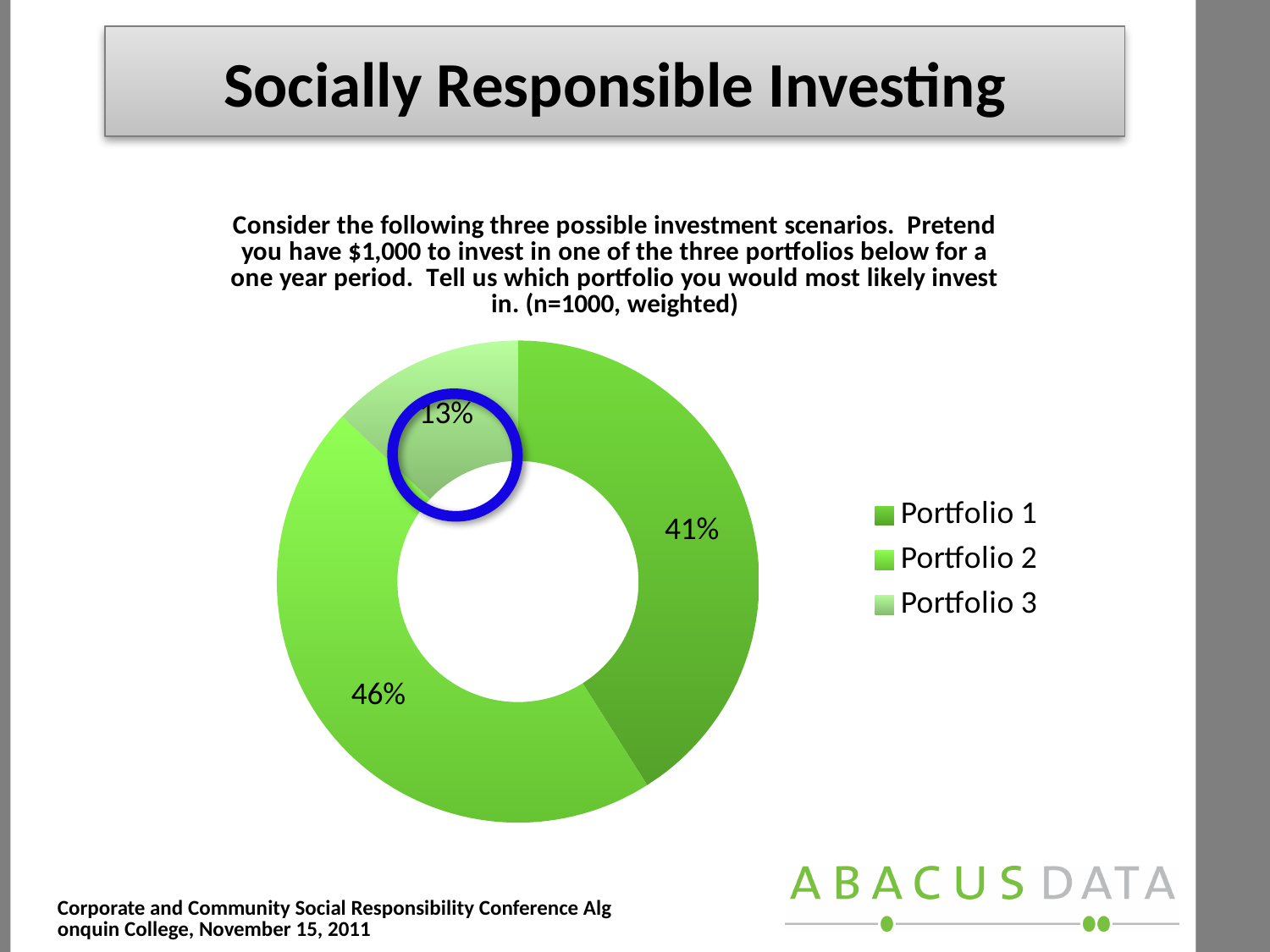
Which portfolio has the smallest share of respondents? Portfolio 3 Which portfolio has the largest share of respondents? Portfolio 2 What percentage of respondents chose Portfolio 3? 13% What is the difference in percentage points between Portfolio 1 and Portfolio 3? 28 Which has a larger share, Portfolio 1 or Portfolio 3? Portfolio 1 What kind of chart is shown on the slide? Doughnut (pie) chart What percentage of respondents chose Portfolio 2? 46% Which slice of the chart is circled in blue? Portfolio 3 What percentage of respondents chose Portfolio 1? 41% How many entries does the legend list? 3 What is the difference in percentage points between Portfolio 2 and Portfolio 1? 5 How many portfolios are shown in the chart? 3